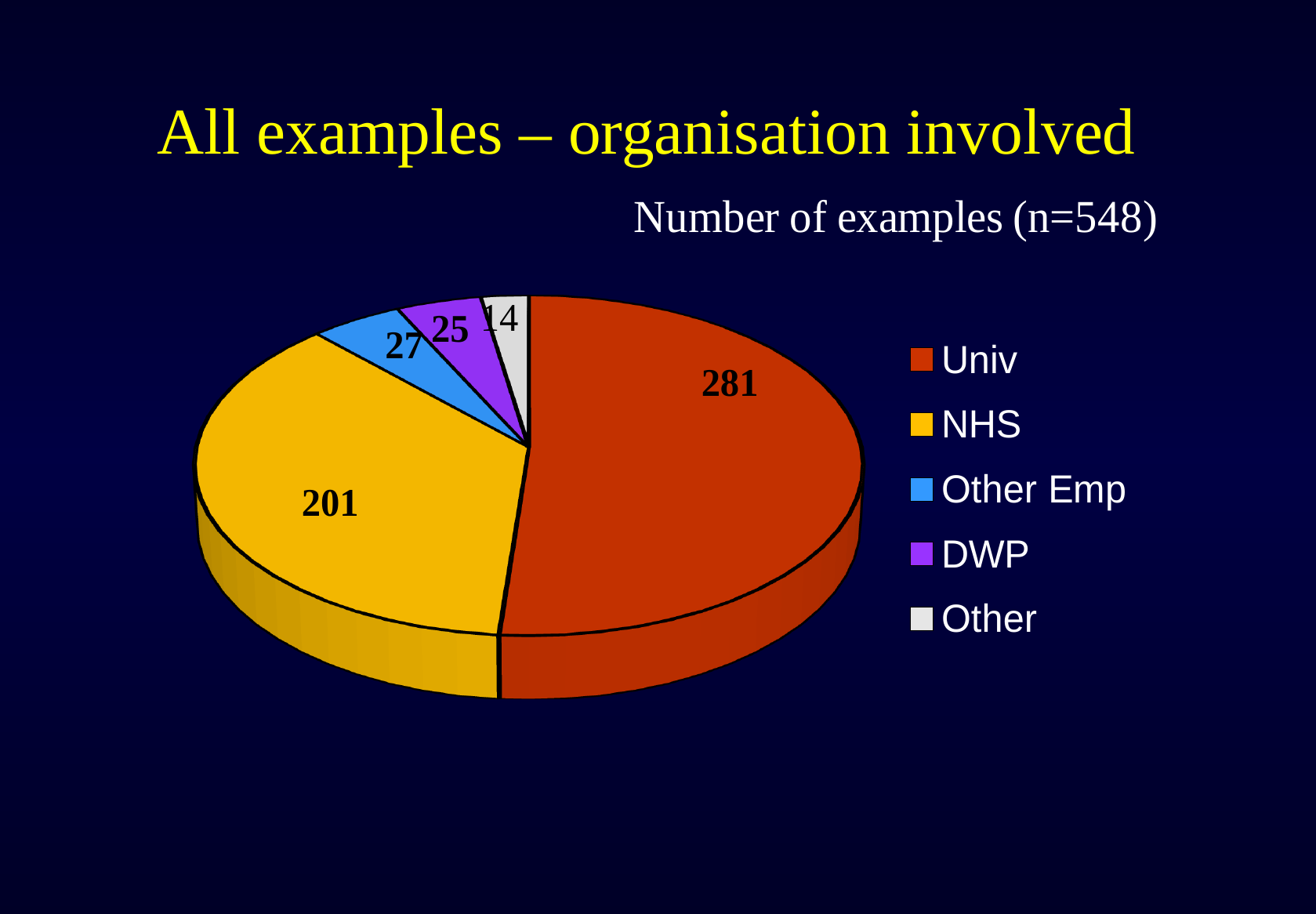
Which organisation has the smallest slice of the pie? Other What is the value shown for Other Emp? 27 Which organisation has the largest slice of the pie? Univ What type of chart is shown on the slide? Pie chart How many examples involved DWP? 25 How many examples involved a university (Univ)? 281 How many categories does the pie chart show? 5 According to the chart subtitle, what is the total number of examples (n)? 548 Which is larger, the NHS slice or the Univ slice? Univ What is the difference between the Univ and NHS values? 80 What is the difference between the Other Emp and DWP values? 2 What is the value shown for the NHS slice? 201